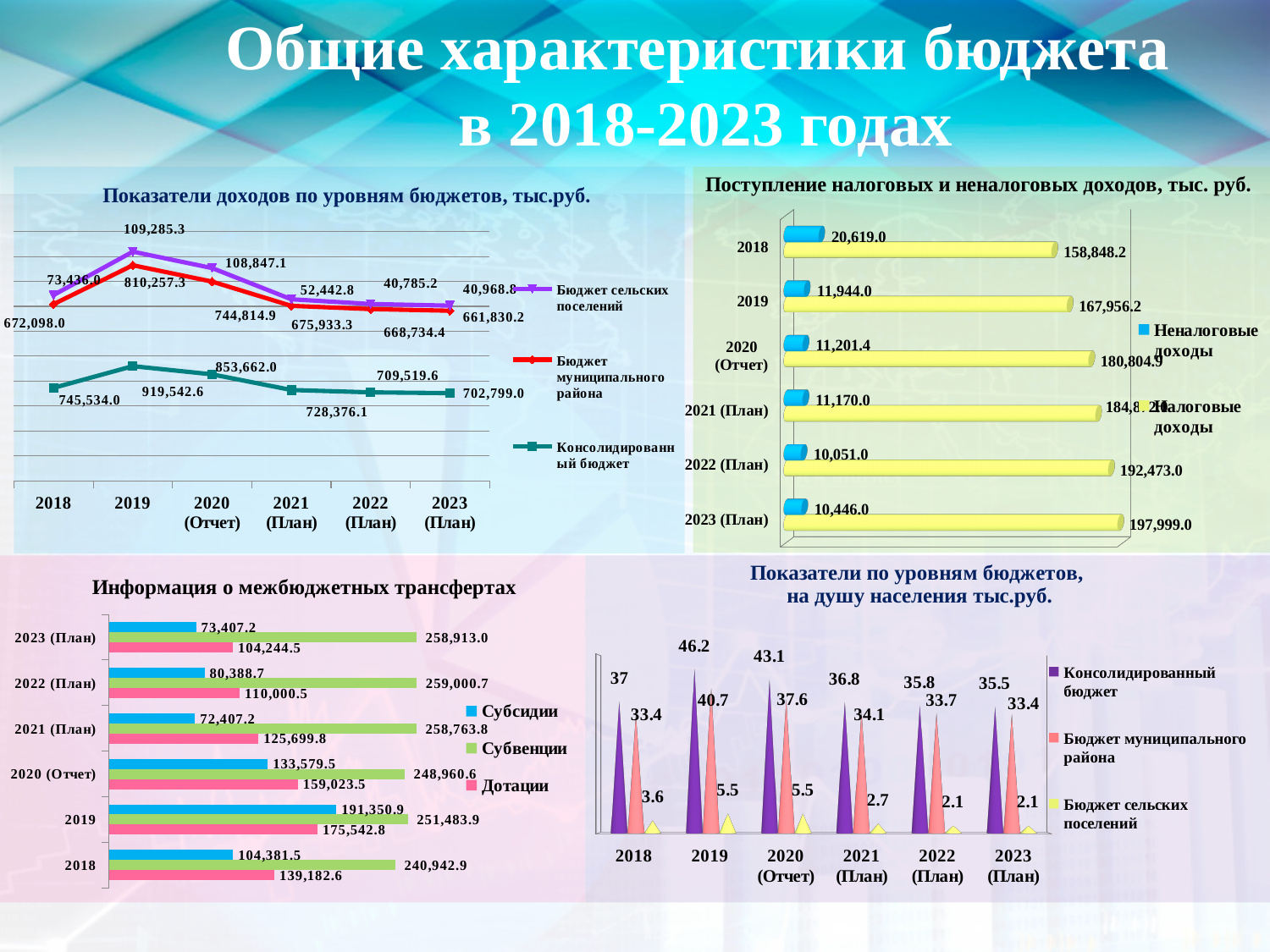
In the chart 'Поступление налоговых и неналоговых доходов, тыс. руб.', in which year are Налоговые доходы highest? 2023 (План) In the chart 'Поступление налоговых и неналоговых доходов, тыс. руб.', what is the difference between Налоговые доходы in 2023 (План) and 2022 (План)? 5,526.0 In the chart 'Показатели доходов по уровням бюджетов, тыс.руб.', in which year is Бюджет сельских поселений highest? 2019 In the chart 'Информация о межбюджетных трансфертах', what is the value of Субвенции for 2022 (План)? 259,000.7 In the chart 'Показатели по уровням бюджетов, на душу населения тыс.руб.', what is the value of Консолидированный бюджет for 2019? 46.2 In the chart 'Показатели по уровням бюджетов, на душу населения тыс.руб.', what is the lowest value of Бюджет сельских поселений? 2.1 In the chart 'Поступление налоговых и неналоговых доходов, тыс. руб.', what is the value of Неналоговые доходы for 2018? 20,619.0 In the chart 'Показатели доходов по уровням бюджетов, тыс.руб.', how many series does the legend list? 3 In the chart 'Показатели доходов по уровням бюджетов, тыс.руб.', what is the value of Консолидированный бюджет for 2019? 919,542.6 In the chart 'Информация о межбюджетных трансфертах', which is larger for 2018: Дотации or Субсидии? Дотации In the chart 'Информация о межбюджетных трансфертах', in which year are Субсидии highest? 2019 In the chart 'Показатели по уровням бюджетов, на душу населения тыс.руб.', how many years are shown on the x axis? 6